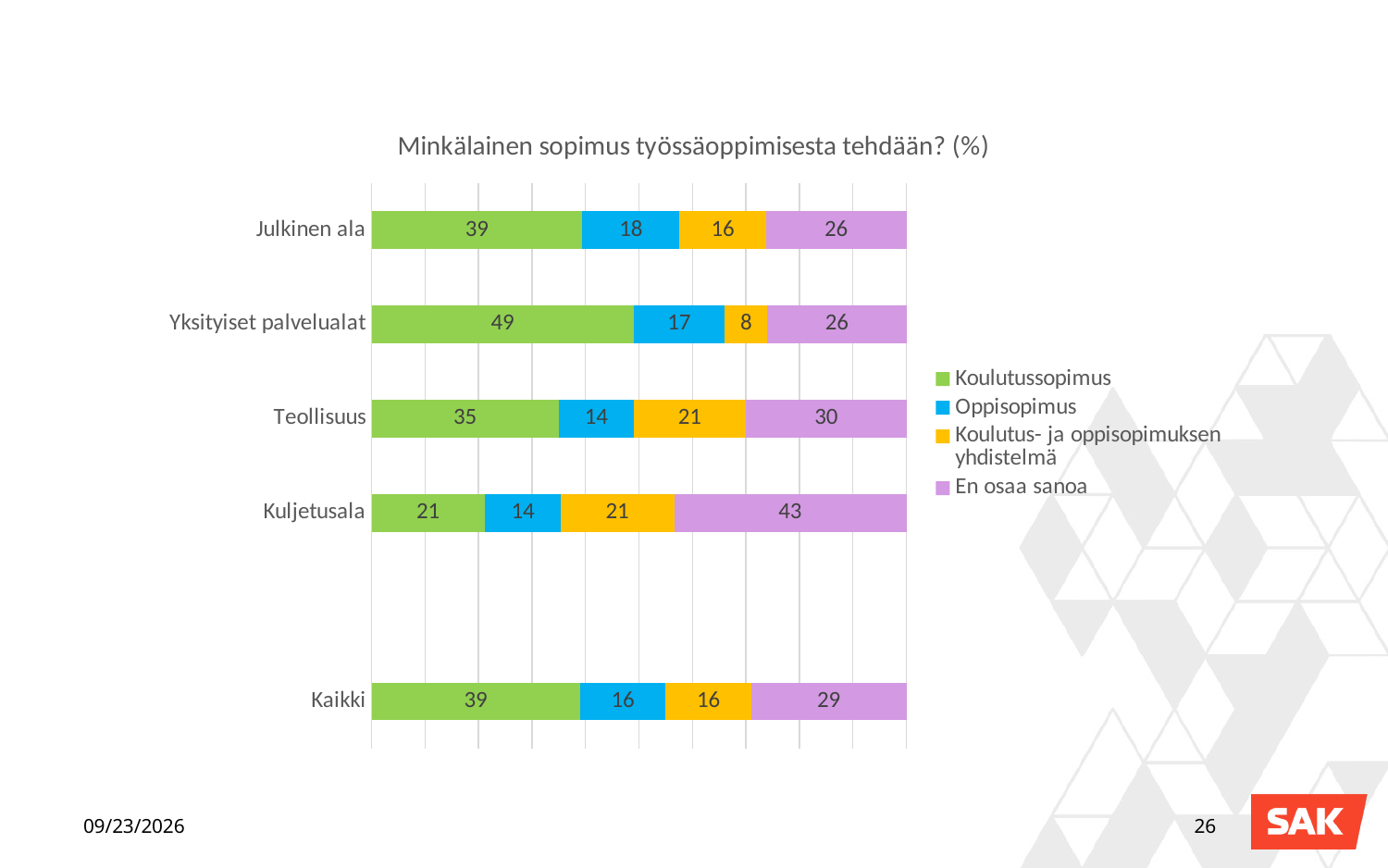
Which category has the lowest Koulutus- ja oppisopimuksen yhdistelmä value? Yksityiset palvelualat What is the total of the stacked bar for Teollisuus? 100 What is the En osaa sanoa value for Kuljetusala? 43 What is the Koulutus- ja oppisopimuksen yhdistelmä value for Teollisuus? 21 What is the Koulutussopimus value for Yksityiset palvelualat? 49 Which is larger: the En osaa sanoa value for Teollisuus or for Kaikki? Teollisuus How many series does the legend list? 4 Which category has the highest Koulutussopimus value? Yksityiset palvelualat What is the Oppisopimus value for Julkinen ala? 18 What is the difference between the Koulutussopimus values for Yksityiset palvelualat and Kuljetusala? 28 What kind of chart is shown on the slide? Stacked bar chart How many categories are shown on the chart? 5